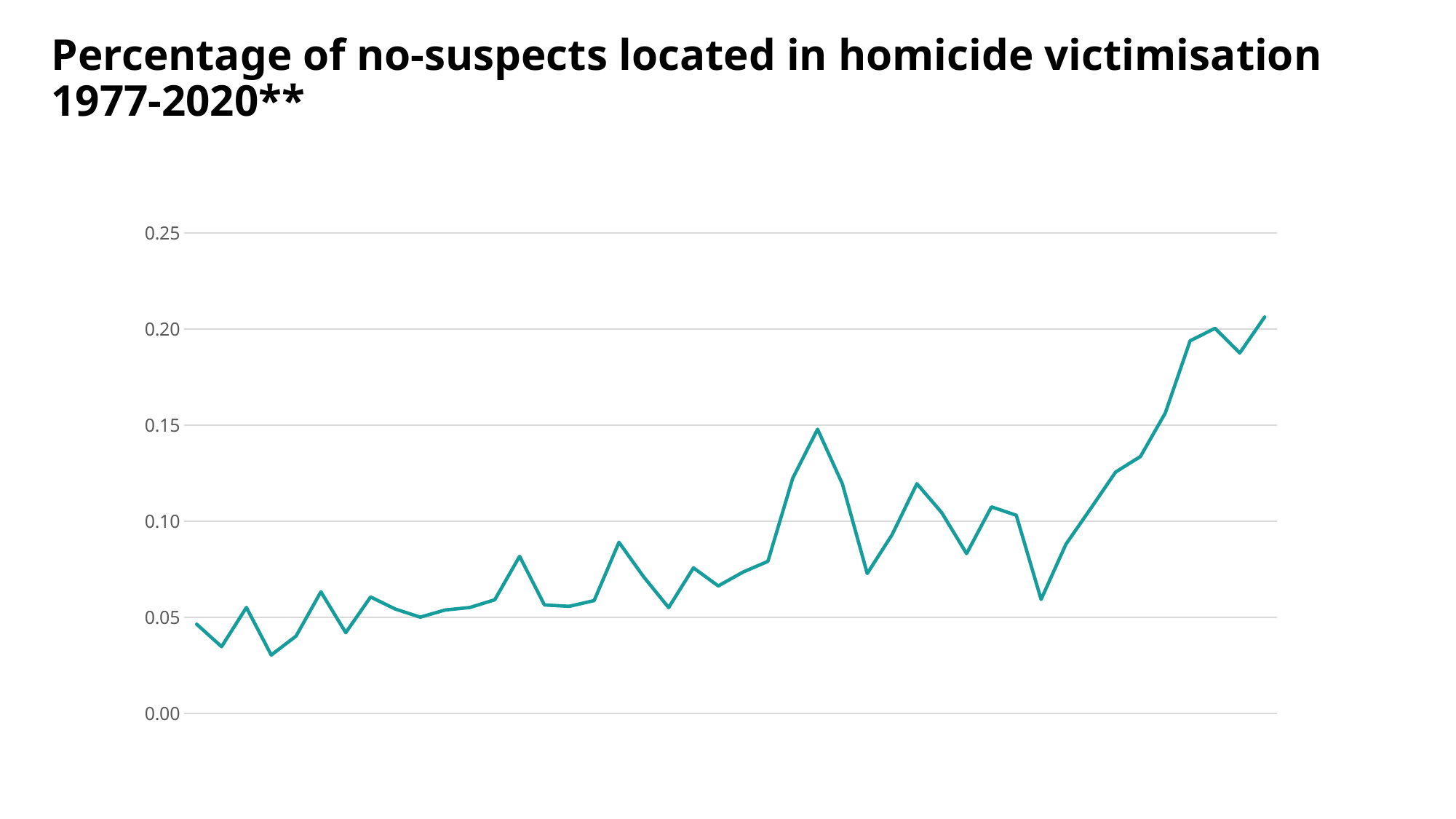
Does the line reach its highest value near the left end or near the right end of the chart? near the right end Overall, do the values rise or fall from left to right along the x axis? rise What is the title of the chart? Percentage of no-suspects located in homicide victimisation 1977-2020** What is the highest value labelled on the y axis? 0.25 Is the value at the last (rightmost) point of the line greater or less than 0.15? greater What kind of chart is shown on the slide? line chart Is the value at the last point of the line larger or smaller than the value at the first point? larger Is the lowest point of the line greater or less than 0.05? less Is the value at the first (leftmost) point of the line greater or less than 0.10? less